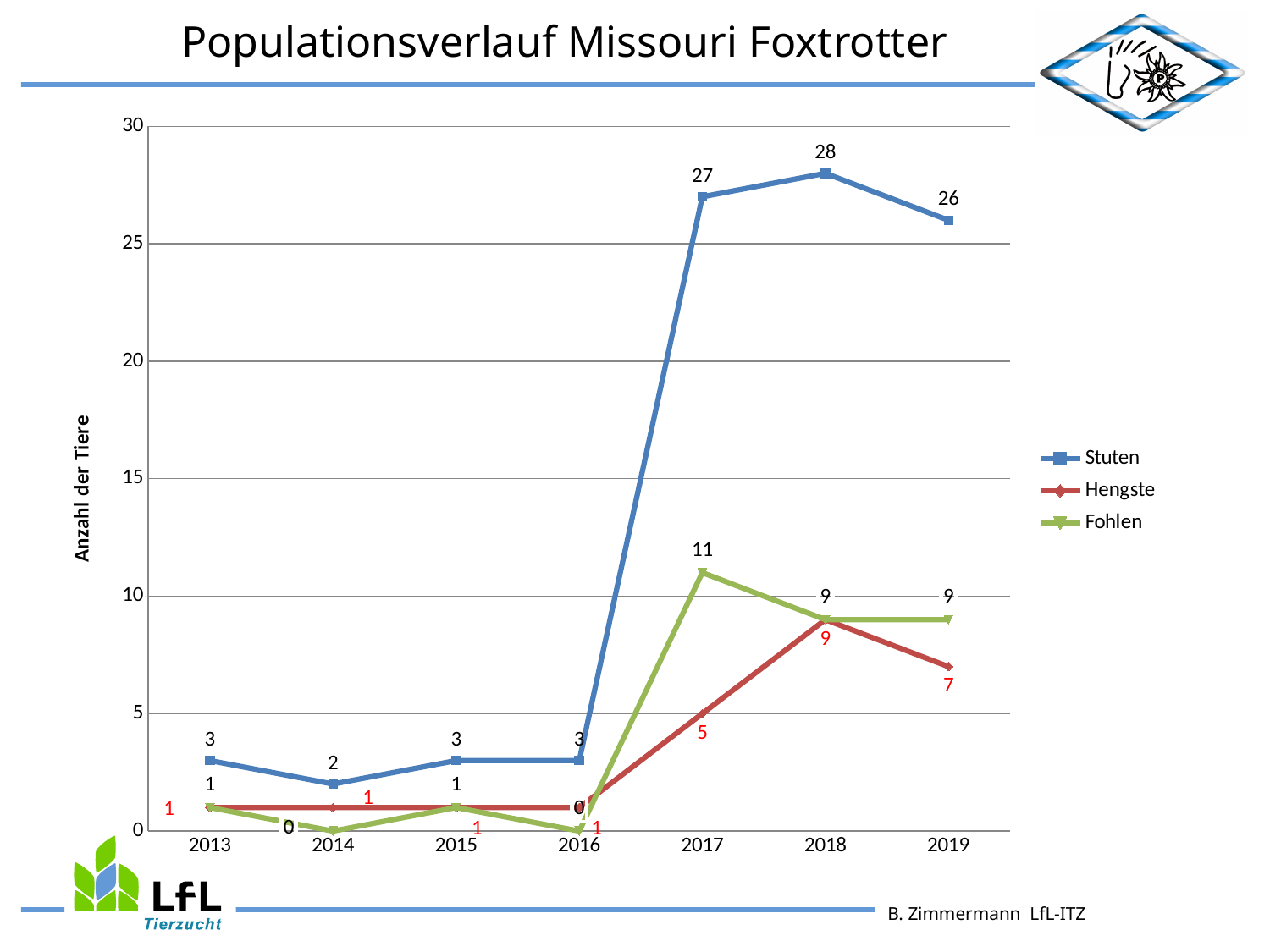
In which year is the value for Stuten highest? 2018 How many series does the legend list? 3 Is the value for Stuten in 2019 greater or less than 25? greater What is the value for Hengste in 2019? 7 In which year is the value for Stuten lowest? 2014 What is the difference between the Stuten value in 2017 and the Stuten value in 2016? 24 What is the value for Fohlen in 2017? 11 What is the title of the chart? Populationsverlauf Missouri Foxtrotter What kind of chart is shown on the slide? line chart What is the value for Stuten in 2018? 28 Which is larger in 2019, the value for Hengste or the value for Fohlen? Fohlen How many years are shown on the x axis? 7